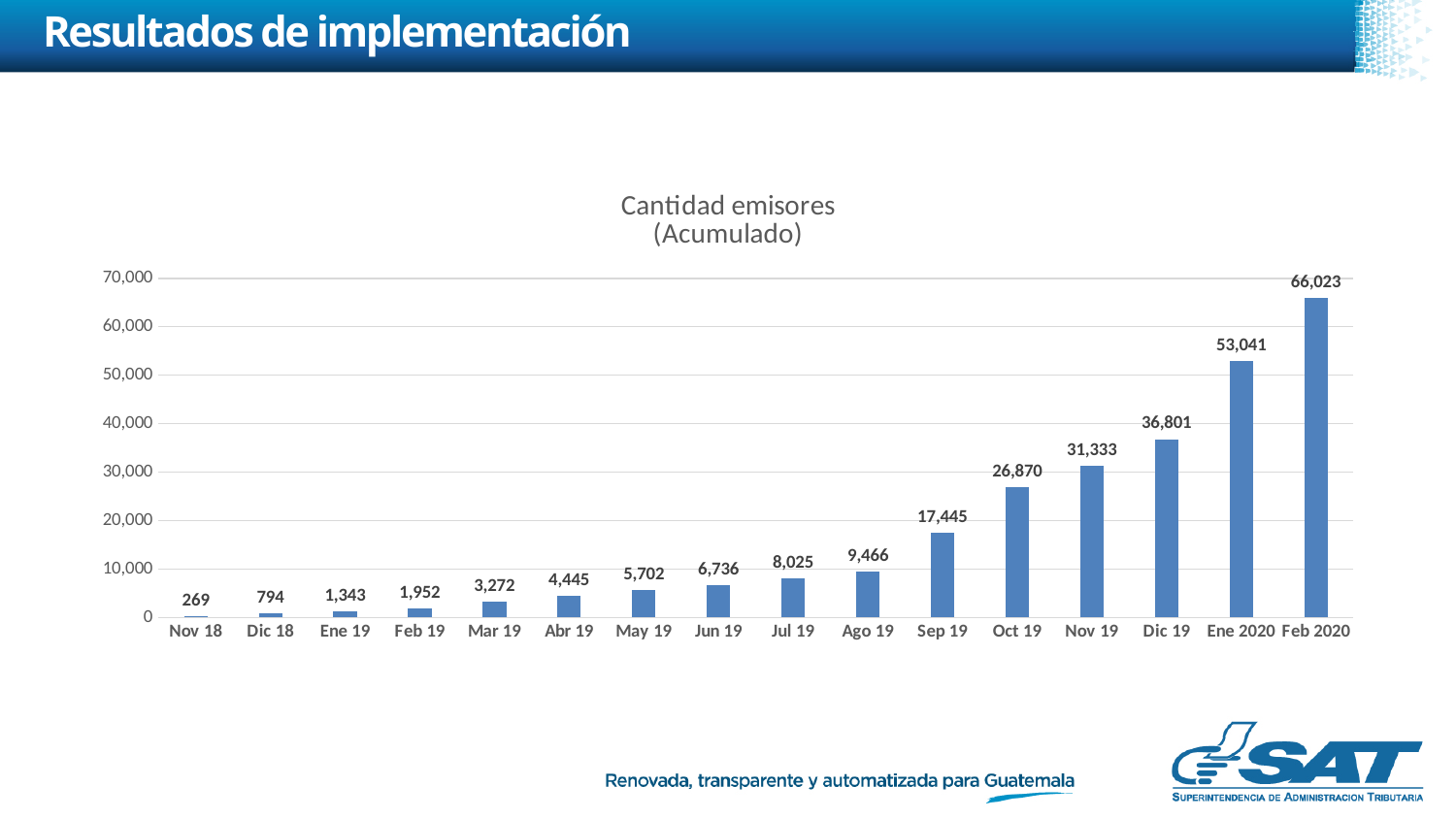
What is the difference between the values for Feb 2020 and Ene 2020? 12,982 What is the value for Abr 19? 4,445 Do the values rise or fall from Nov 18 to Feb 2020? rise What is the title of the chart? Cantidad emisores (Acumulado) How many months are shown on the x axis? 16 What is the value for Sep 19? 17,445 Which month has the lowest value? Nov 18 Which is larger, the value for Oct 19 or the value for Nov 19? Nov 19 What kind of chart is shown? bar chart What is the value for Ene 2020? 53,041 Is the value for Dic 19 greater or less than 40,000? less Which month has the highest value? Feb 2020